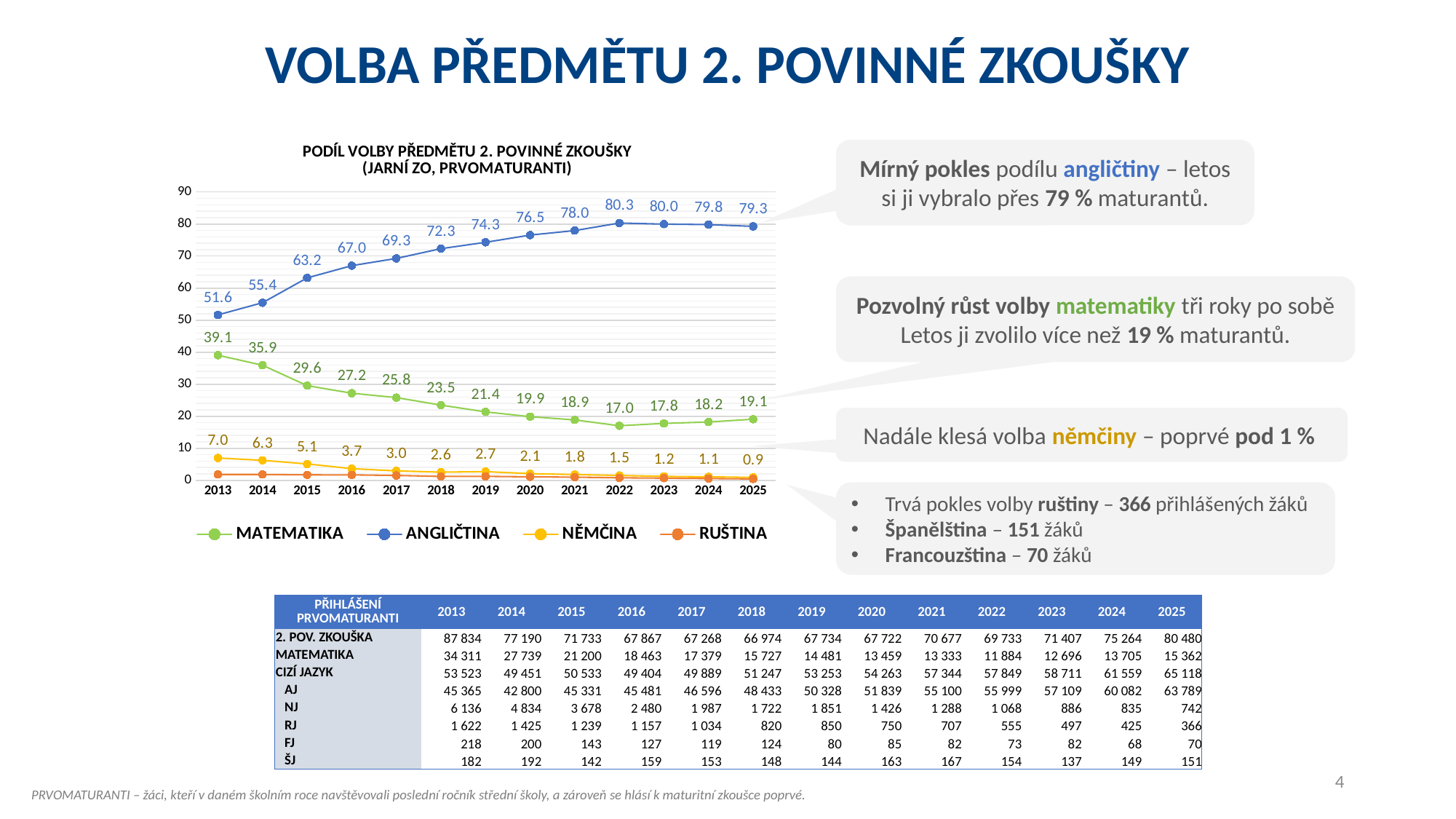
How many years are plotted along the x axis of the chart? 13 Which is larger in 2020, the value for MATEMATIKA or the value for NĚMČINA? MATEMATIKA How many series does the chart legend list? 4 What is the value for MATEMATIKA in 2013? 39.1 What type of chart is shown on the slide? line chart What is the value for NĚMČINA in 2025? 0.9 In which year does the ANGLIČTINA series reach its highest value? 2022 Is the value for RUŠTINA in 2013 greater or less than 10? less What is the difference between the ANGLIČTINA values in 2025 and 2013? 27.7 In which year does the MATEMATIKA series reach its lowest value? 2022 What is the value for ANGLIČTINA in 2025? 79.3 Does the NĚMČINA series rise or fall from 2013 to 2025? fall